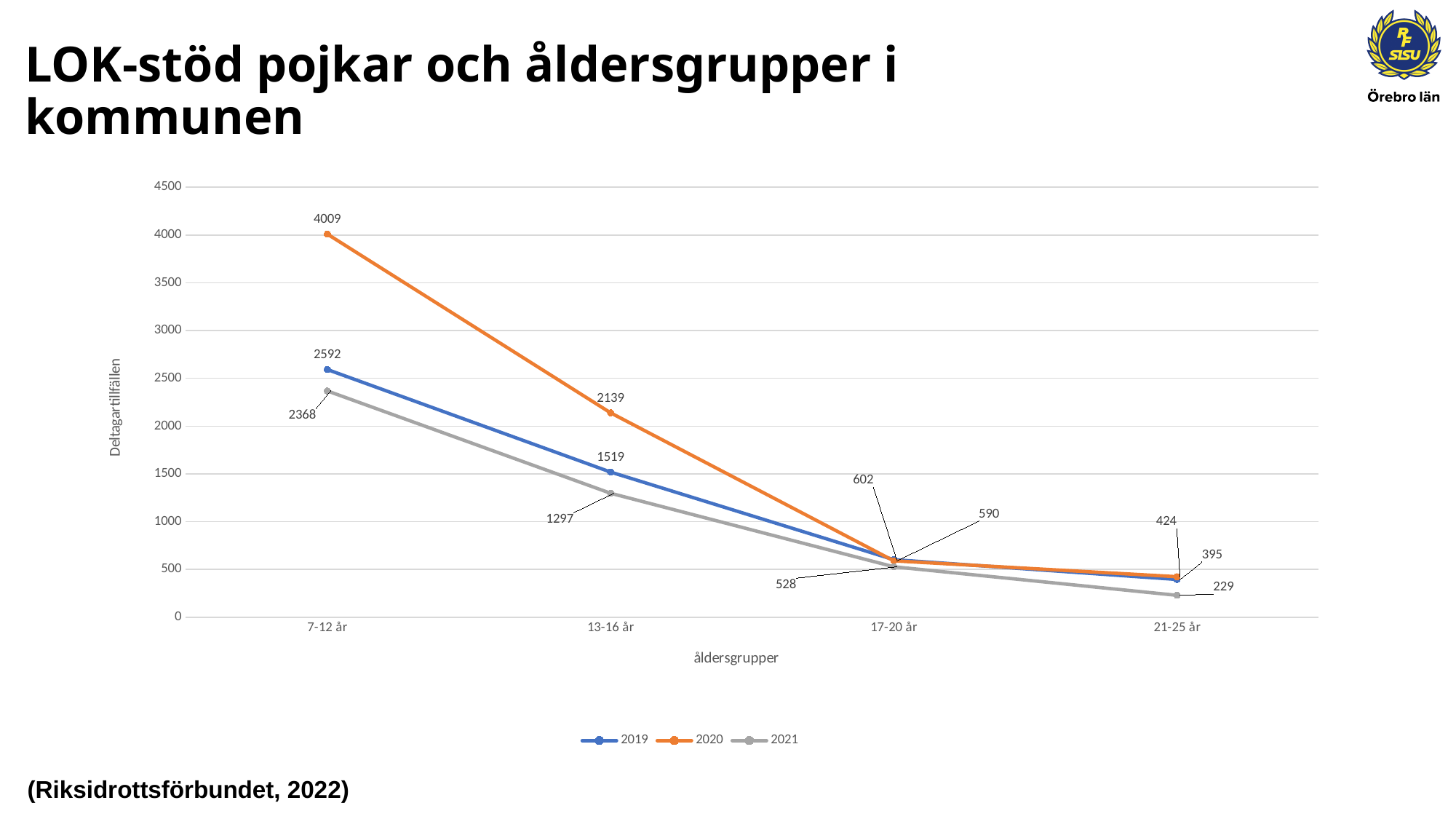
What is the value for 2019 in the 13-16 år age group? 1519 What is the difference between the 2020 and 2019 values in the 7-12 år age group? 1417 What is the value for 2021 in the 17-20 år age group? 528 What kind of chart is shown on the slide? Line chart How many age groups are shown on the x axis? 4 In the 13-16 år age group, which series has the larger value, 2019 or 2021? 2019 How many series does the legend list? 3 What is the value for 2021 in the 21-25 år age group? 229 Which age group has the highest value for the 2020 series? 7-12 år Which age group has the lowest value for the 2021 series? 21-25 år Do the values for the 2020 series rise or fall from 7-12 år to 21-25 år? Fall What is the value for 2020 in the 7-12 år age group? 4009